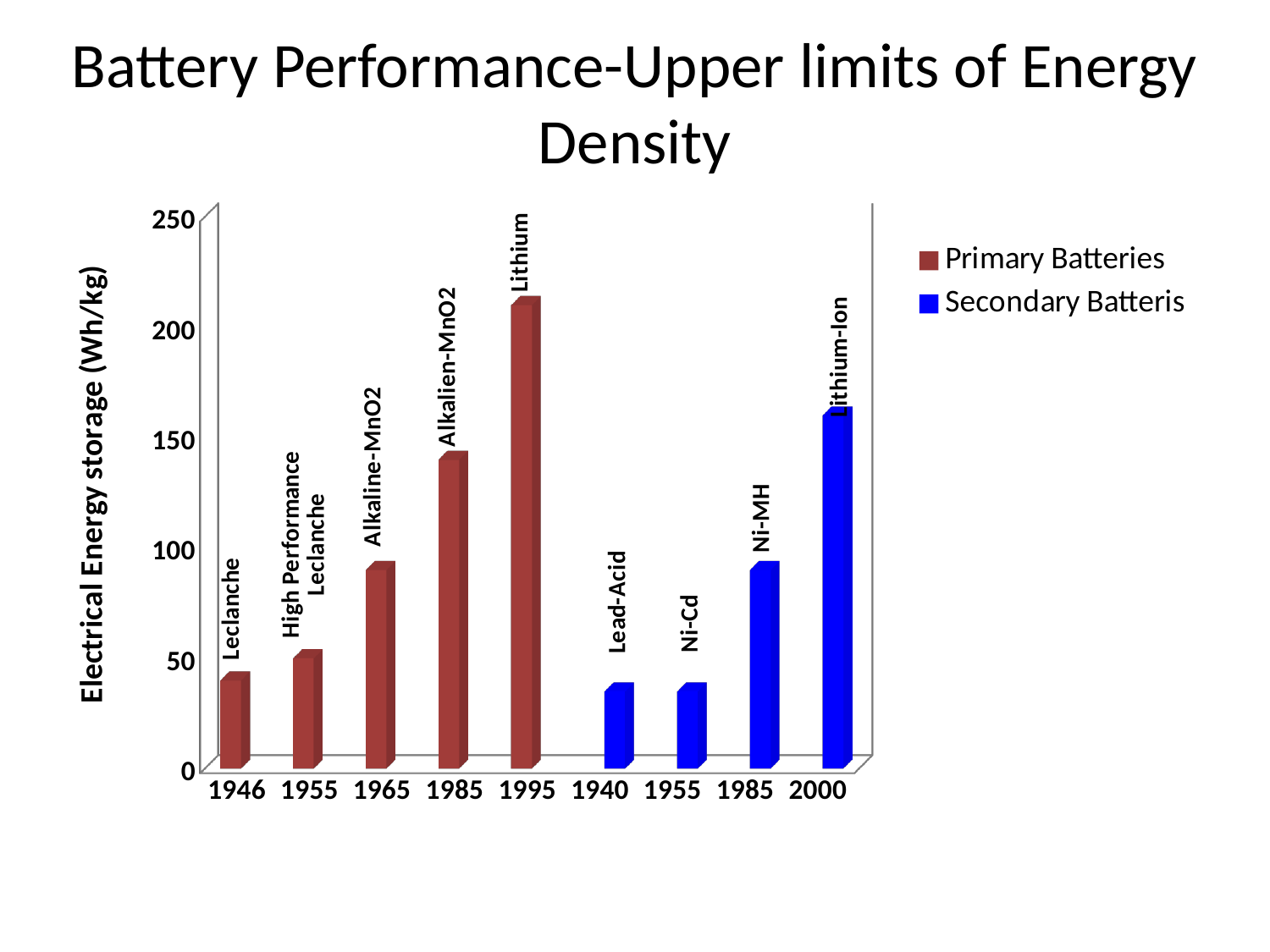
Is the value for Lead-Acid greater or less than 50? less Is the value for Lithium greater or less than 200? greater Do the values for the Primary Batteries series rise or fall from 1946 to 1995? rise Which battery has the highest energy storage value in the chart? Lithium Is the value for Lithium-Ion greater or less than 150? greater What kind of chart is shown on the slide? bar chart How many bars are plotted in the chart? 9 What is the title of the vertical axis? Electrical Energy storage (Wh/kg) Which is larger, the value for Lithium or the value for Lithium-Ion? Lithium Which is larger, the value for Alkalien-MnO2 or the value for Ni-MH? Alkalien-MnO2 How many series does the legend list? 2